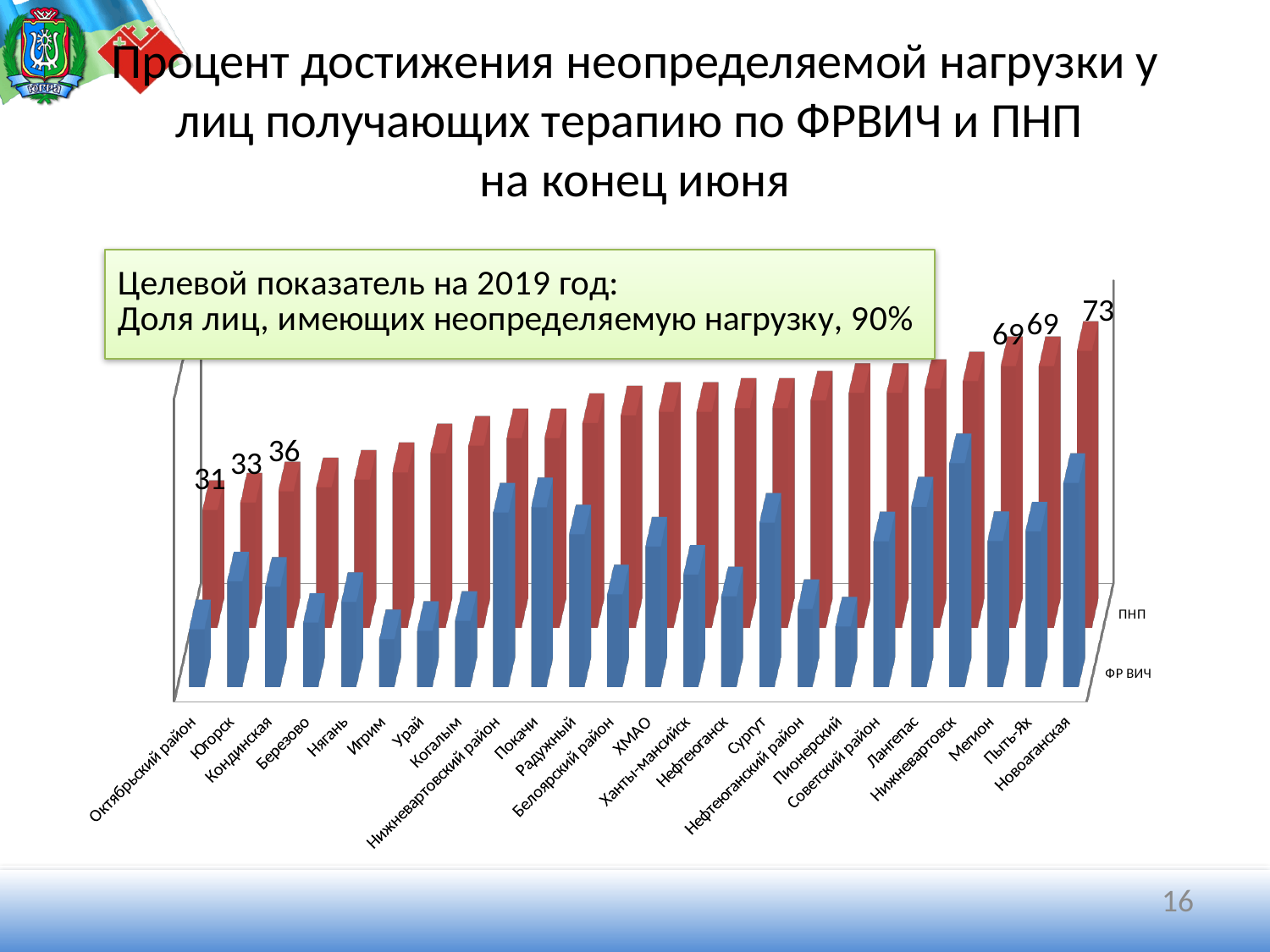
Which category has the highest ПНП value? Новоаганская What is the ПНП value for Пыть-Ях? 69 What is the ПНП value for Кондинская? 36 Do the ПНП values rise or fall moving from left to right along the x axis? rise Which category has the lowest ПНП value? Октябрьский район What are the two series named in the chart legend? ПНП and ФР ВИЧ What is the ПНП value for Октябрьский район? 31 What is the difference between the ПНП values for Новоаганская and Октябрьский район? 42 How many categories (territories) are shown along the x axis of the chart? 24 How many series does the chart's legend list? 2 What type of chart is shown on the slide? bar chart What is the ПНП value for Новоаганская? 73